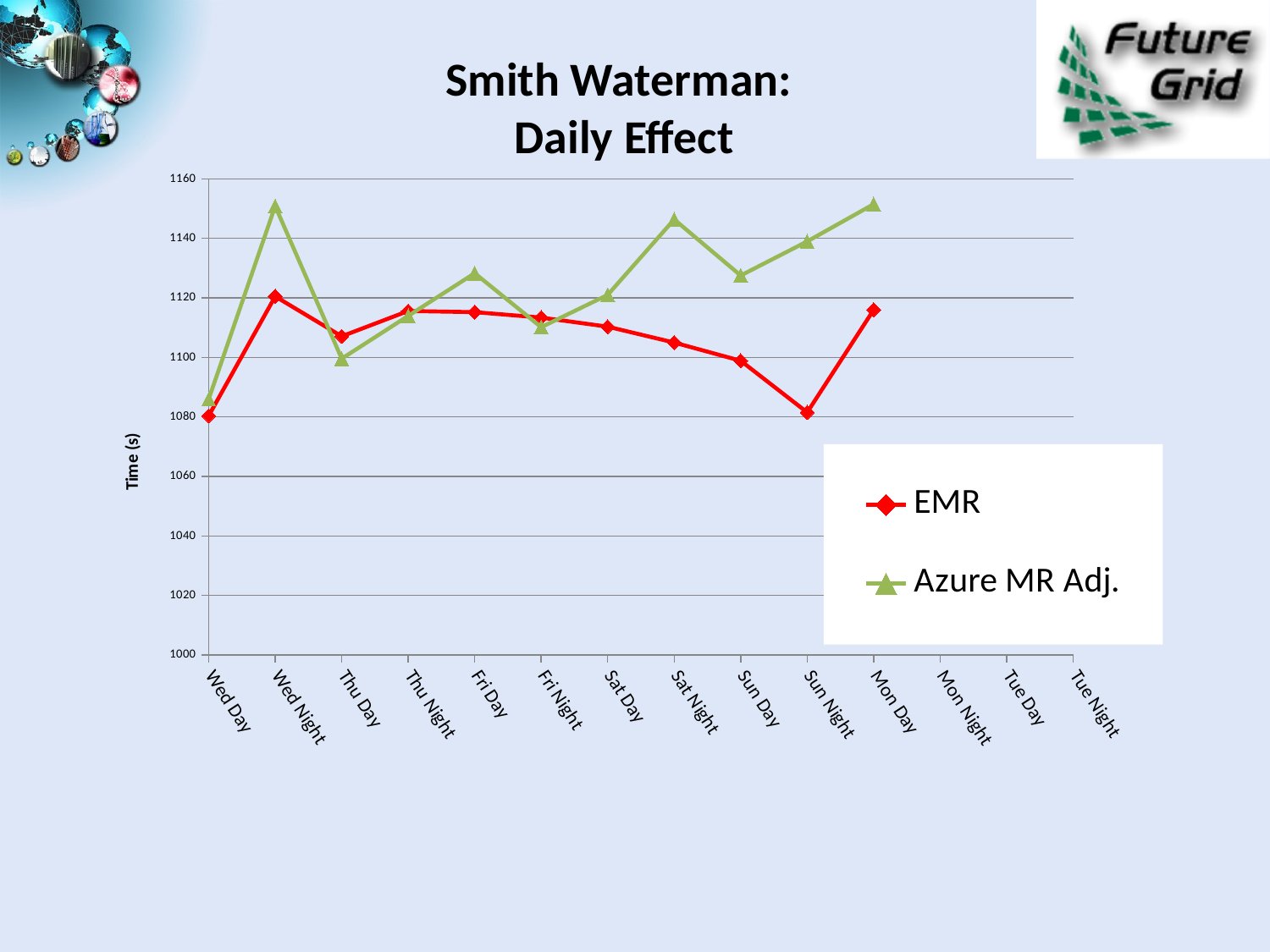
How many series does the legend list? 2 Is the Azure MR Adj. value for Wed Night greater or less than 1140? greater What are the two series named in the legend? EMR and Azure MR Adj. Is the Azure MR Adj. value for Fri Day greater or less than 1120? greater Does the EMR line rise or fall from Thu Night to Sun Night? fall For which category is the Azure MR Adj. value lowest? Wed Day How many category labels are shown along the x axis? 14 At Wed Night, which series has the higher value, EMR or Azure MR Adj.? Azure MR Adj. What is the label of the vertical axis? Time (s) Is the EMR value for Sun Night greater or less than 1100? less What kind of chart is shown on the slide? line chart